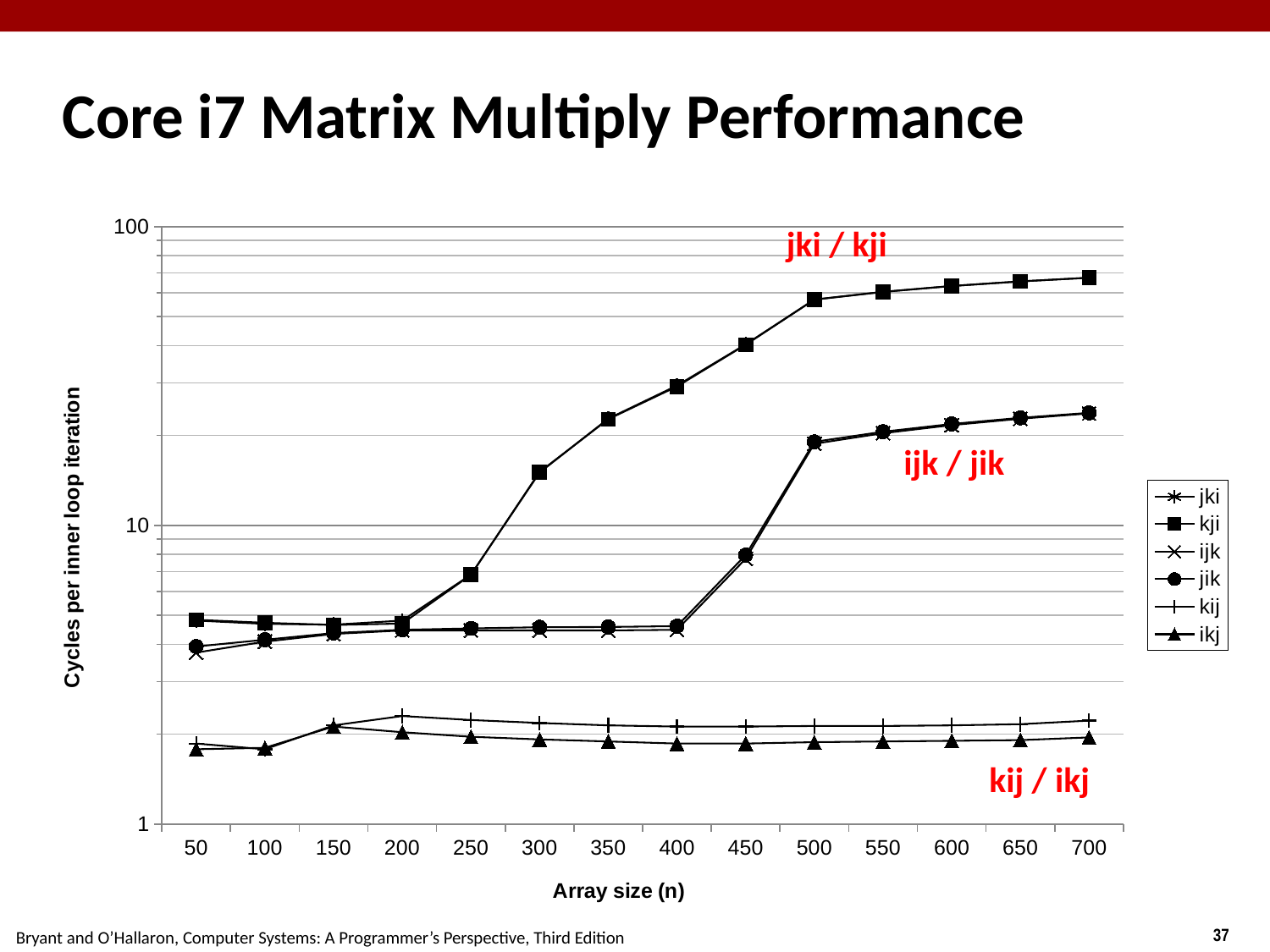
How many array sizes are plotted along the x axis? 14 What is the label of the y axis? Cycles per inner loop iteration Is the value for kji at array size 700 greater or less than 10? greater Is the value for jik at array size 500 greater or less than 10? greater Is the value for kij at array size 700 greater or less than 10? less What kind of chart is shown on the slide? line chart At array size 300, which is larger, the value for kji or the value for jik? kji How many series does the legend list? 6 Does the kji series rise or fall as the array size increases from 200 to 700? rise At array size 700, which is larger, the value for kji or the value for ikj? kji